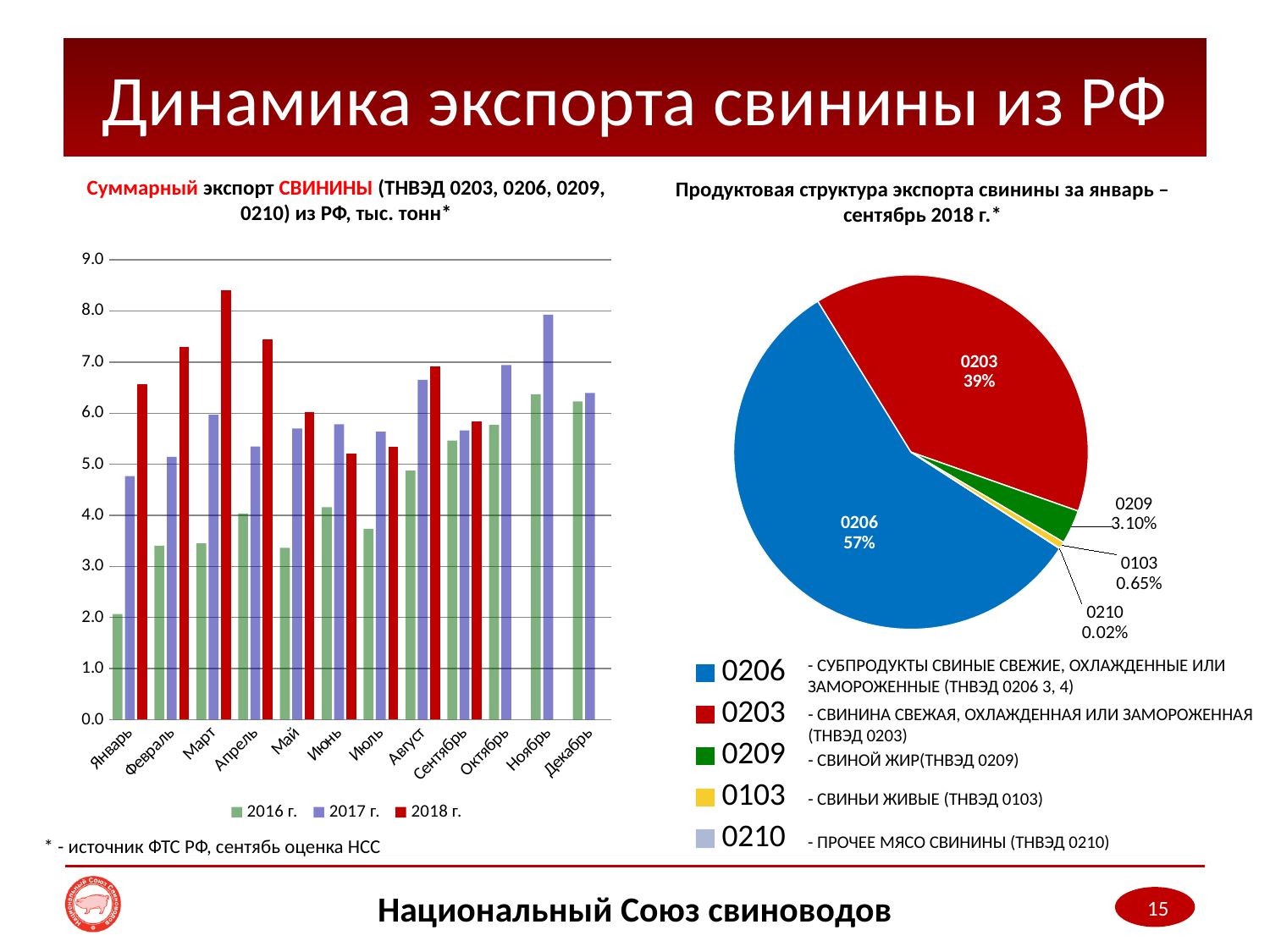
On the left chart (Суммарный экспорт СВИНИНЫ), in which month is the 2018 г. value highest? Март On the left chart (Суммарный экспорт СВИНИНЫ), is the 2016 г. value for Январь greater or less than 3.0? less On the left chart (Суммарный экспорт СВИНИНЫ), is the 2018 г. value for Март greater or less than 8.0? greater On the left chart (Суммарный экспорт СВИНИНЫ), what kind of chart is it? bar chart On the left chart (Суммарный экспорт СВИНИНЫ), which is larger for 2017 г.: Октябрь or Ноябрь? Ноябрь On the right pie chart (Продуктовая структура экспорта свинины), how many percentage points larger is the 0206 share than the 0203 share? 18 On the left chart (Суммарный экспорт СВИНИНЫ), how many months are shown on the x axis? 12 On the right pie chart (Продуктовая структура экспорта свинины), what is the value shown for 0209? 3.10% On the left chart (Суммарный экспорт СВИНИНЫ), how many series does the legend list? 3 On the right pie chart (Продуктовая структура экспорта свинины), which category has the smallest share? 0210 On the right pie chart (Продуктовая структура экспорта свинины), what share does 0206 have? 57% On the left chart (Суммарный экспорт СВИНИНЫ), in which month is the 2016 г. value lowest? Январь